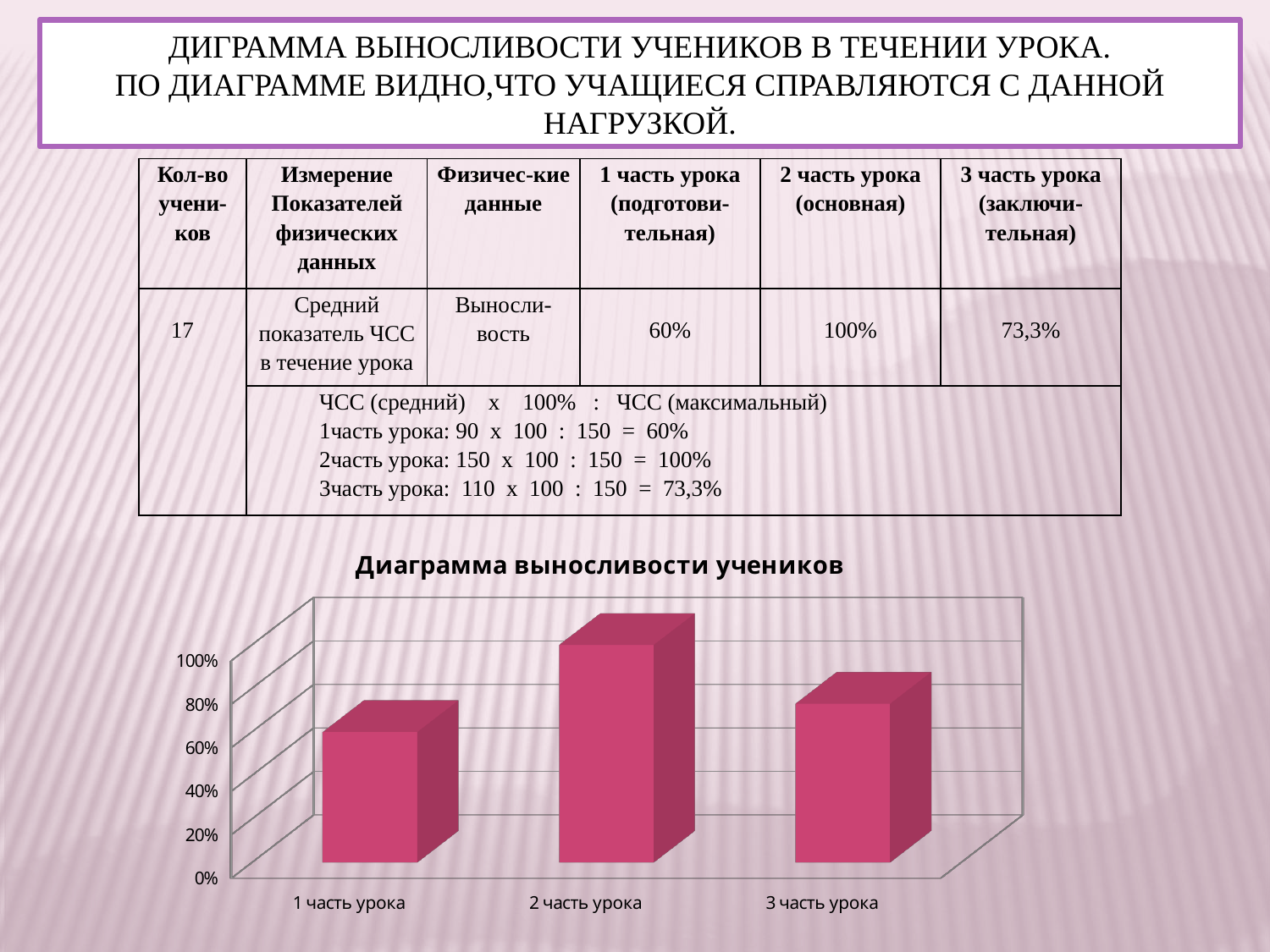
What colour are the bars in the chart? pink (magenta) How many categories are shown on the x axis of the chart? 3 Is the value for 3 часть урока greater or less than 40%? greater Which bar is taller: 1 часть урока or 3 часть урока? 3 часть урока Is the value for 1 часть урока greater or less than 80%? less What type of chart is shown on the slide? bar chart Which bar is taller: 2 часть урока or 3 часть урока? 2 часть урока Is the value for 2 часть урока greater or less than 80%? greater Which part of the lesson has the highest bar in the chart? 2 часть урока Which part of the lesson has the lowest bar in the chart? 1 часть урока Does the value rise or fall from 2 часть урока to 3 часть урока? fall What is the title of the chart? Диаграмма выносливости учеников